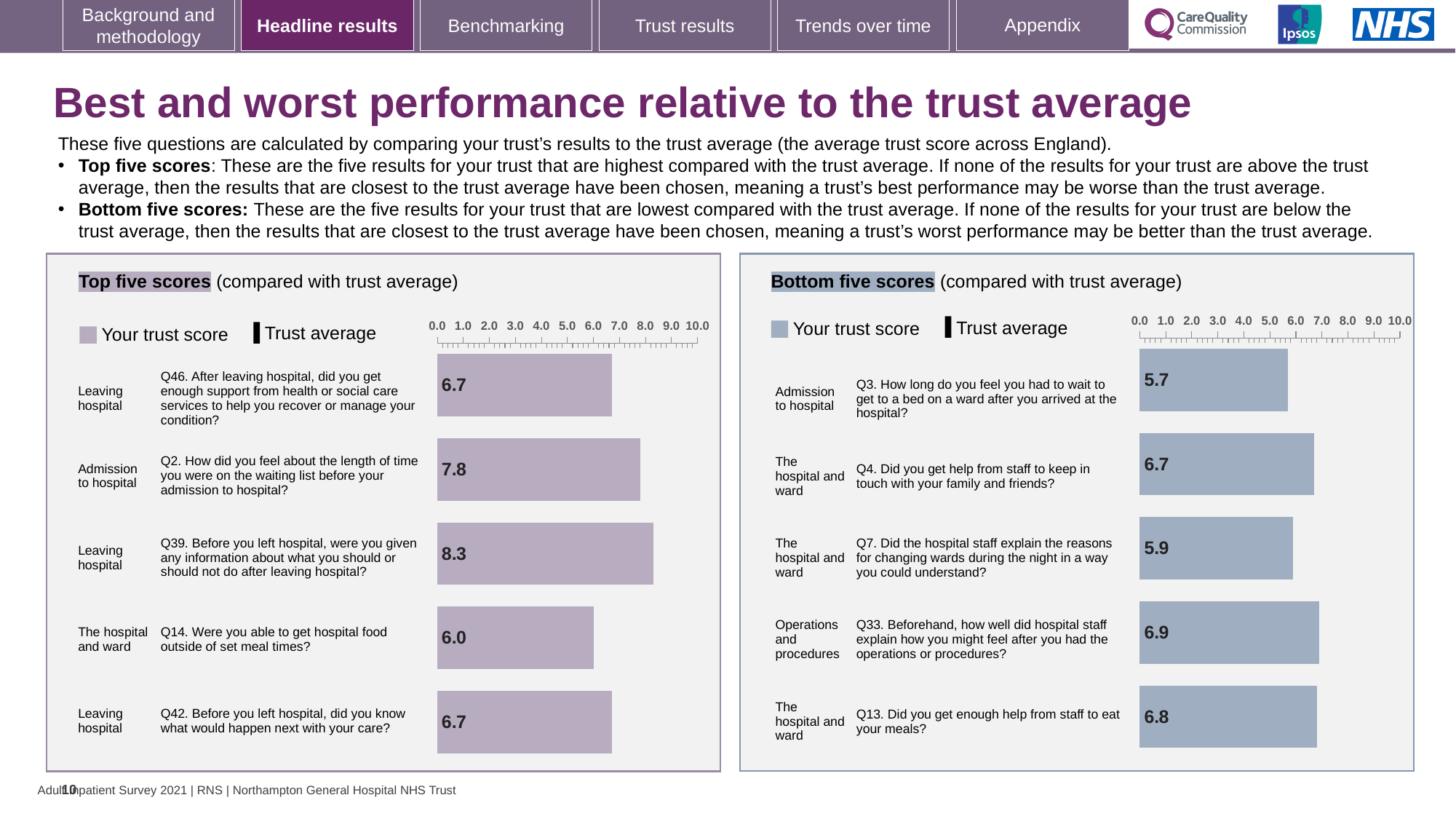
In the Bottom five scores chart, what is the trust score for Q3 about waiting to get to a bed on a ward? 5.7 How many questions are shown in the Top five scores chart? 5 In the Top five scores chart, which question has the lowest trust score? Q14 In the Top five scores chart, what is the difference between the scores for Q39 and Q14? 2.3 What kind of chart is used in the Bottom five scores panel? Bar chart In the Bottom five scores chart, which has the larger score: Q4 or Q13? Q13 How many entries does the legend of the Top five scores chart list? 2 In the Top five scores chart, what is the trust score for Q2 about the length of time on the waiting list before admission? 7.8 In the Bottom five scores chart, which question has the highest trust score? Q33 In the Top five scores chart, which question has the highest trust score? Q39 In the Bottom five scores chart, which question has the lowest trust score? Q3 In the Bottom five scores chart, what is the difference between the scores for Q33 and Q7? 1.0